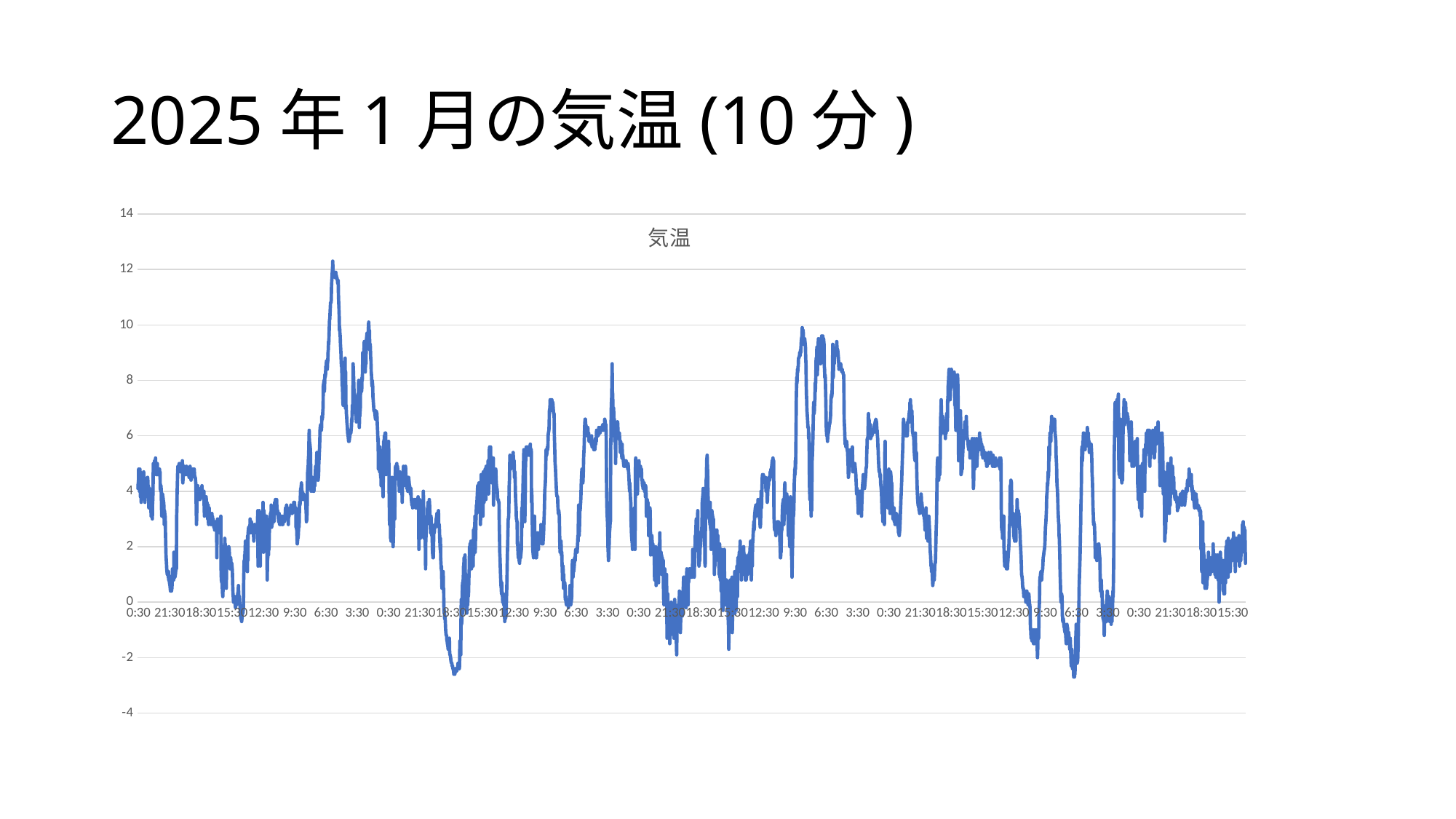
Is the value at the first point on the left (0:30) greater or less than 2? greater Is the value at the last point on the right (15:30) greater or less than 4? less What kind of chart is shown on the slide? line chart What is the title of the chart? 気温 What colour is the line in the chart? blue Is the highest value reached by the line greater or less than 14? less